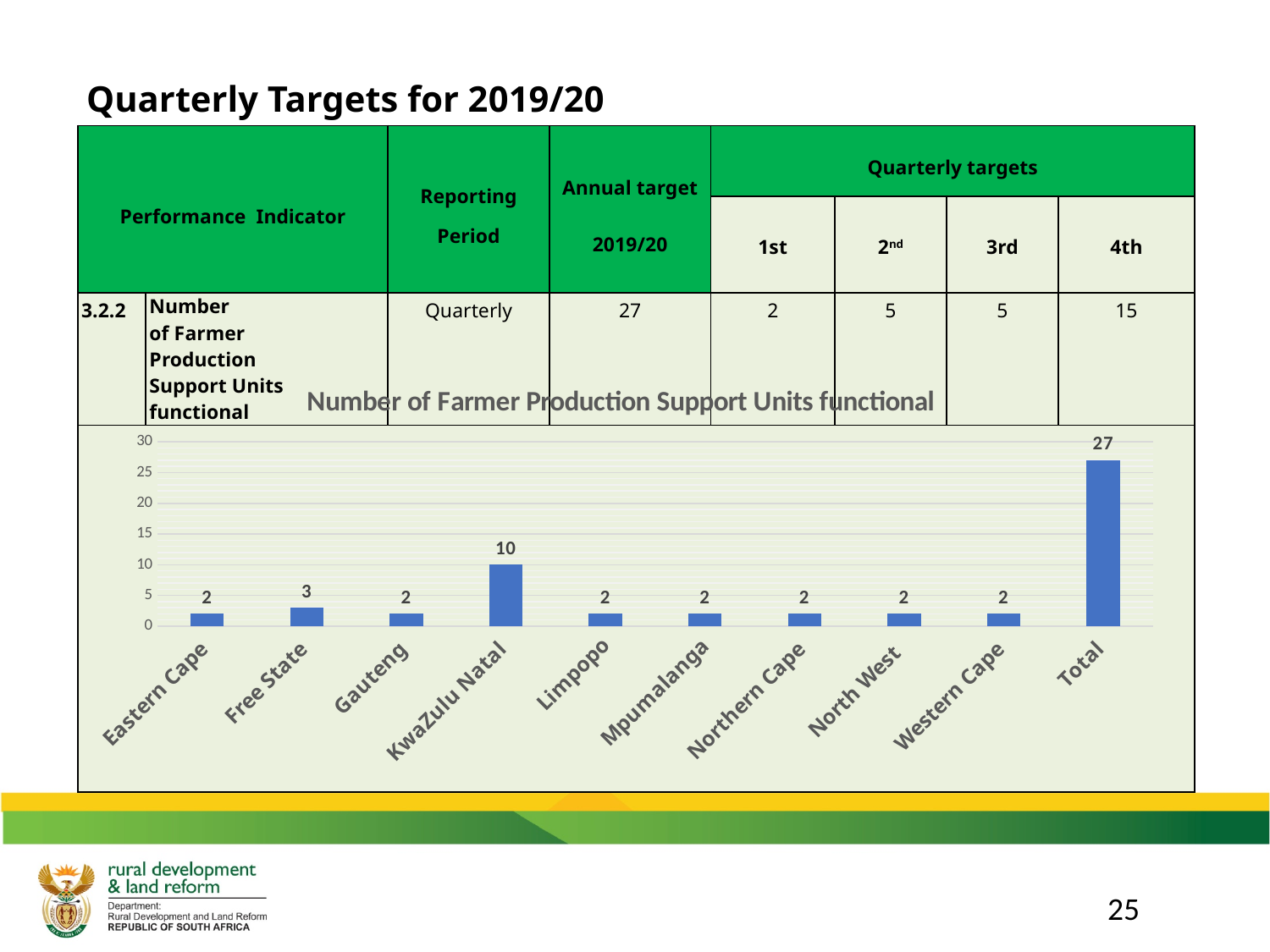
What is the value for Free State? 3 What is the difference between the values for KwaZulu Natal and Free State? 7 What is the value for KwaZulu Natal? 10 Excluding the Total bar, which province has the highest value? KwaZulu Natal What is the title of the chart? Number of Farmer Production Support Units functional Is the value for Total greater or less than 25? greater Which is larger, the value for Free State or the value for Gauteng? Free State What kind of chart is shown on the slide? bar chart What is the value for Eastern Cape? 2 How many provinces have a value of 2? 7 How many categories are shown on the x axis, including Total? 10 What is the value shown for Total? 27